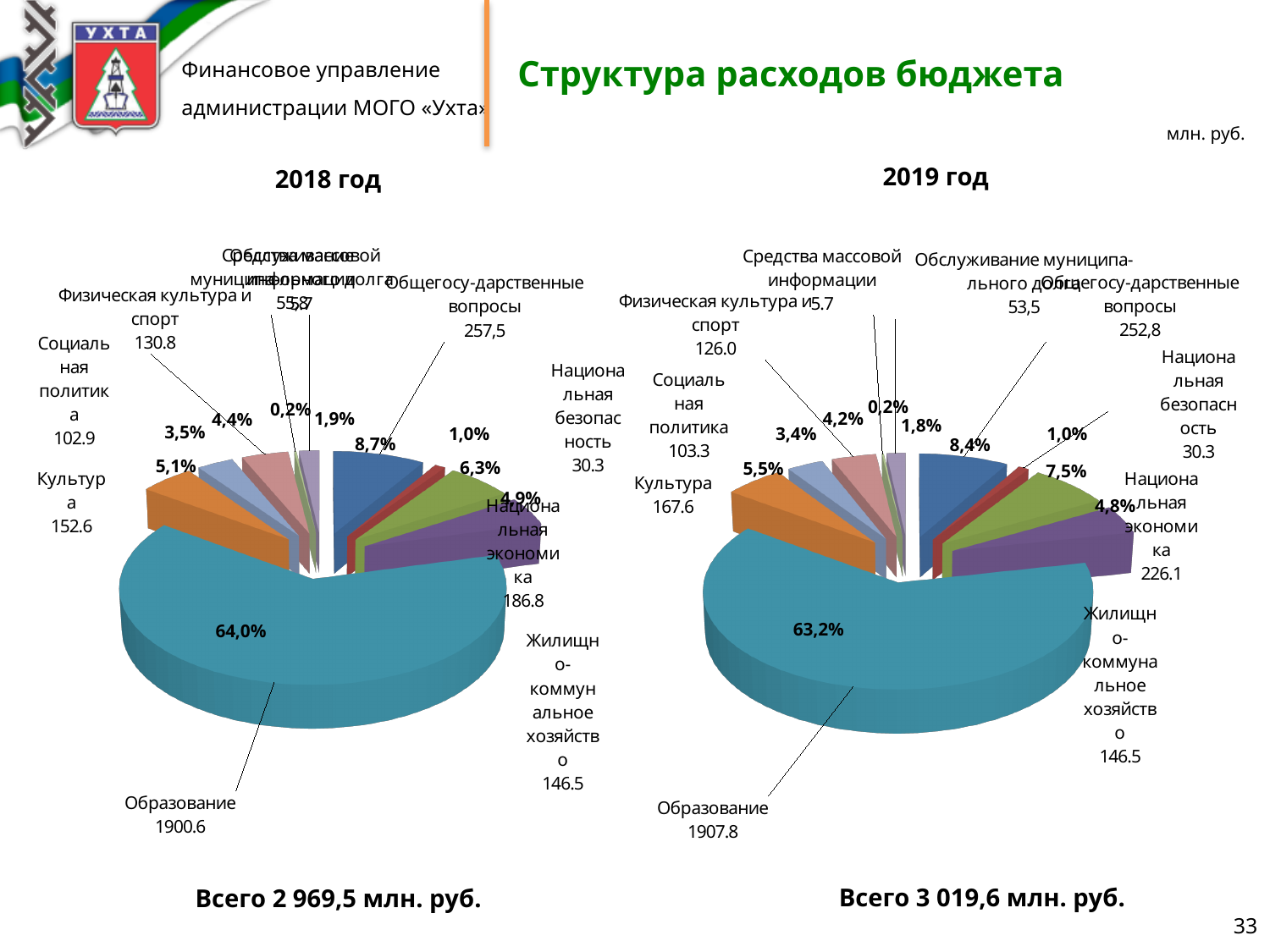
On the 2019 год chart, which category has the smallest slice? Средства массовой информации What total is stated below the 2019 год chart? 3 019,6 млн. руб. What is the difference between the Образование values on the 2019 год chart and the 2018 год chart? 7.2 On the 2019 год chart, which category has the largest slice? Образование What kind of chart is used for 2018 год? Pie chart What is the title of the slide? Структура расходов бюджета On the 2019 год chart, what share of the pie does Образование take? 63,2% On the 2018 год chart, what is the value for Образование? 1900.6 On the 2018 год chart, which is larger: Культура or Социальная политика? Культура On the 2019 год chart, what is the value for Национальная экономика? 226.1 On the 2018 год chart, what share of the pie does Общегосударственные вопросы take? 8,7% How many categories are shown on the 2019 год chart? 10